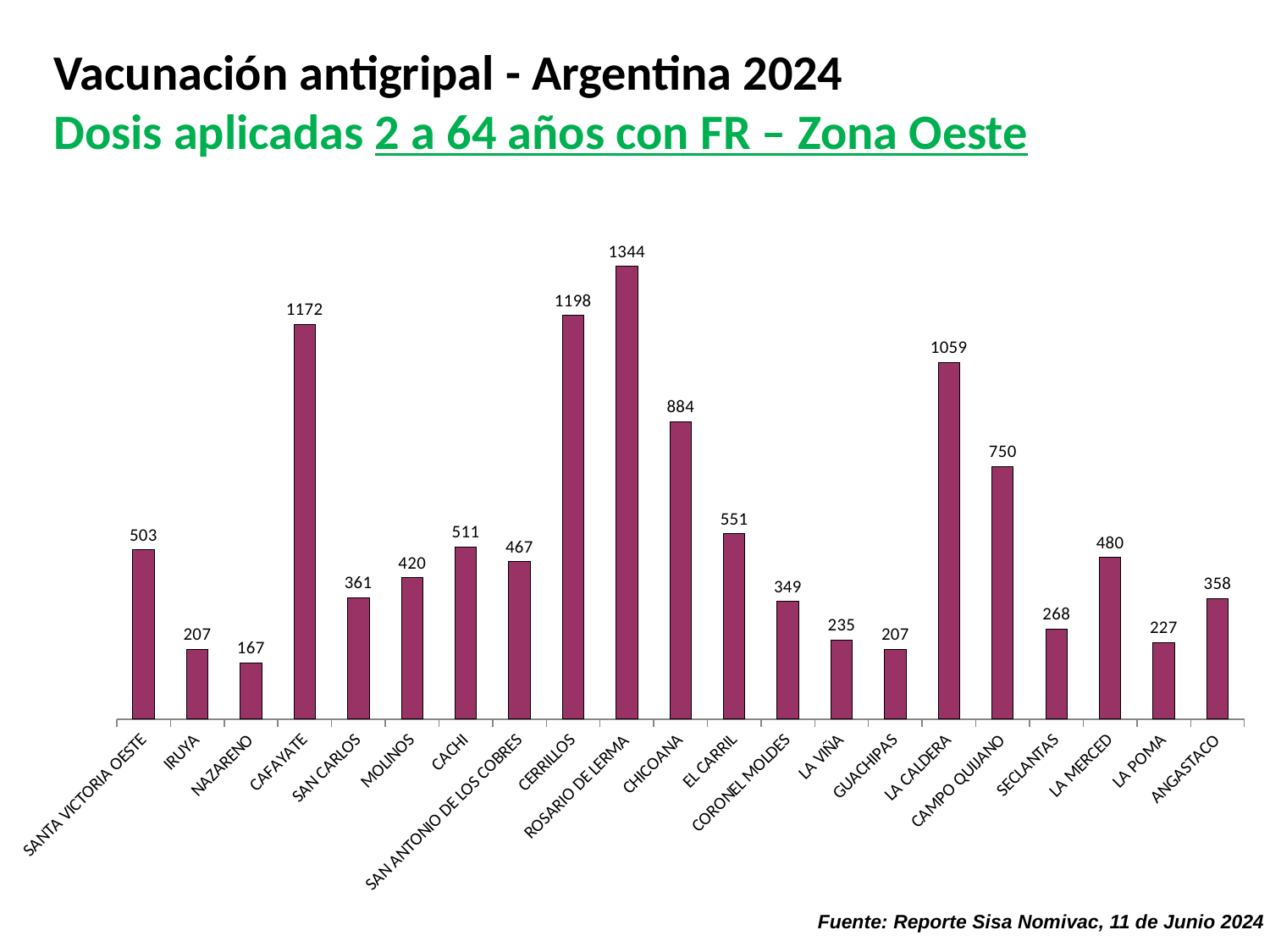
What is the difference between the values for Rosario de Lerma and Cerrillos? 146 What source is cited at the bottom of the slide? Reporte Sisa Nomivac, 11 de Junio 2024 What type of chart is shown on the slide? Bar chart Which has a larger value, Cachi or San Antonio de los Cobres? Cachi What is the value shown for La Merced? 480 How many localities are shown on the x axis? 21 Which has a larger value, Coronel Moldes or Angastaco? Angastaco What is the difference between the values for La Caldera and Campo Quijano? 309 Which locality has the highest number of doses applied? Rosario de Lerma How many doses were applied in Cafayate? 1172 Which locality has the lowest number of doses applied? Nazareno What is the value shown for Chicoana? 884